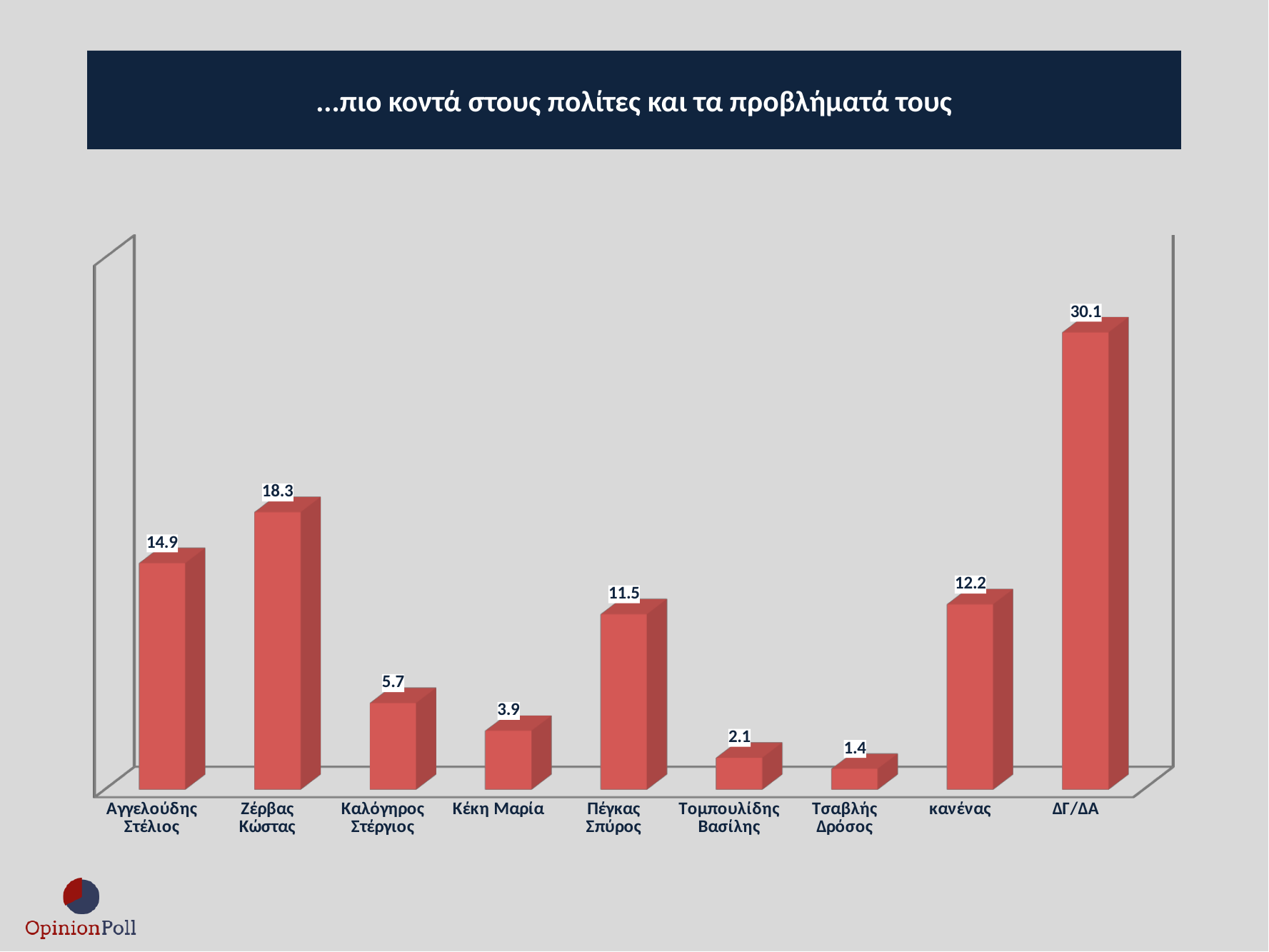
What is the title of the chart? ...πιο κοντά στους πολίτες και τα προβλήματά τους What is the value for κανένας? 12.2 What is the value for Ζέρβας Κώστας? 18.3 What is the value for Αγγελούδης Στέλιος? 14.9 Which is larger, the value for Πέγκας Σπύρος or the value for Καλόγηρος Στέργιος? Πέγκας Σπύρος How many categories are shown on the x axis? 9 What is the difference between the values for Ζέρβας Κώστας and Αγγελούδης Στέλιος? 3.4 Which category has the highest value? ΔΓ/ΔΑ What kind of chart is shown on the slide? bar chart What is the difference between the values for ΔΓ/ΔΑ and κανένας? 17.9 What is the value for Κέκη Μαρία? 3.9 Which category has the lowest value? Τσαβλής Δρόσος